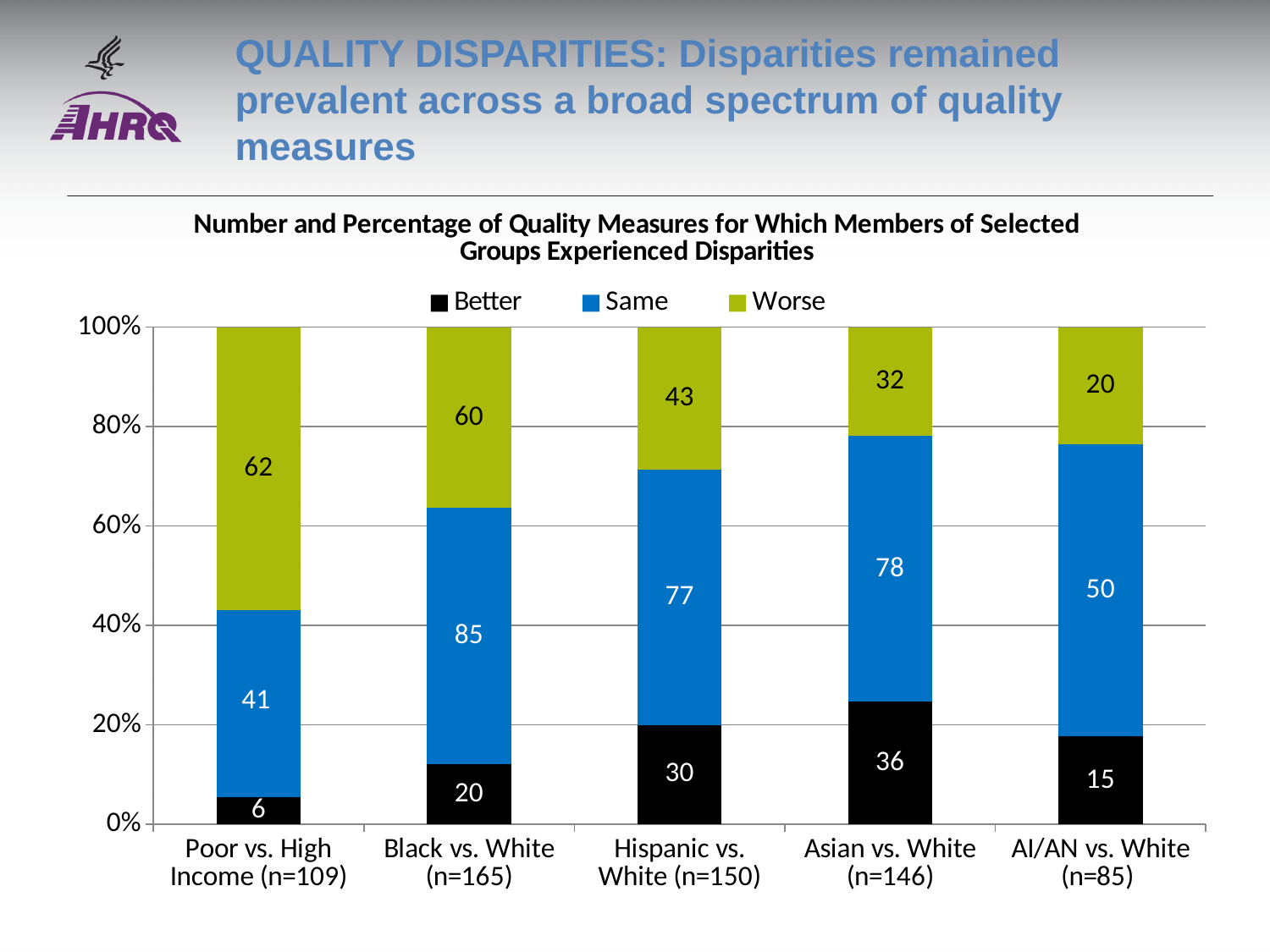
Which group has the highest Worse value? Poor vs. High Income (n=109) How many series does the legend list? 3 Which group has the lowest Better value? Poor vs. High Income (n=109) What is the total of the three values in the Hispanic vs. White (n=150) bar? 150 What is the difference between the Same values for Black vs. White (n=165) and AI/AN vs. White (n=85)? 35 What is the Worse value for Poor vs. High Income (n=109)? 62 Which is larger, the Worse value for Hispanic vs. White (n=150) or the Worse value for Asian vs. White (n=146)? Hispanic vs. White (n=150) Is the Better segment for Asian vs. White (n=146) greater or less than 20% of its bar? greater What kind of chart is shown? stacked bar chart How many groups are shown on the x axis? 5 What is the Same value for Black vs. White (n=165)? 85 What is the Better value for Asian vs. White (n=146)? 36